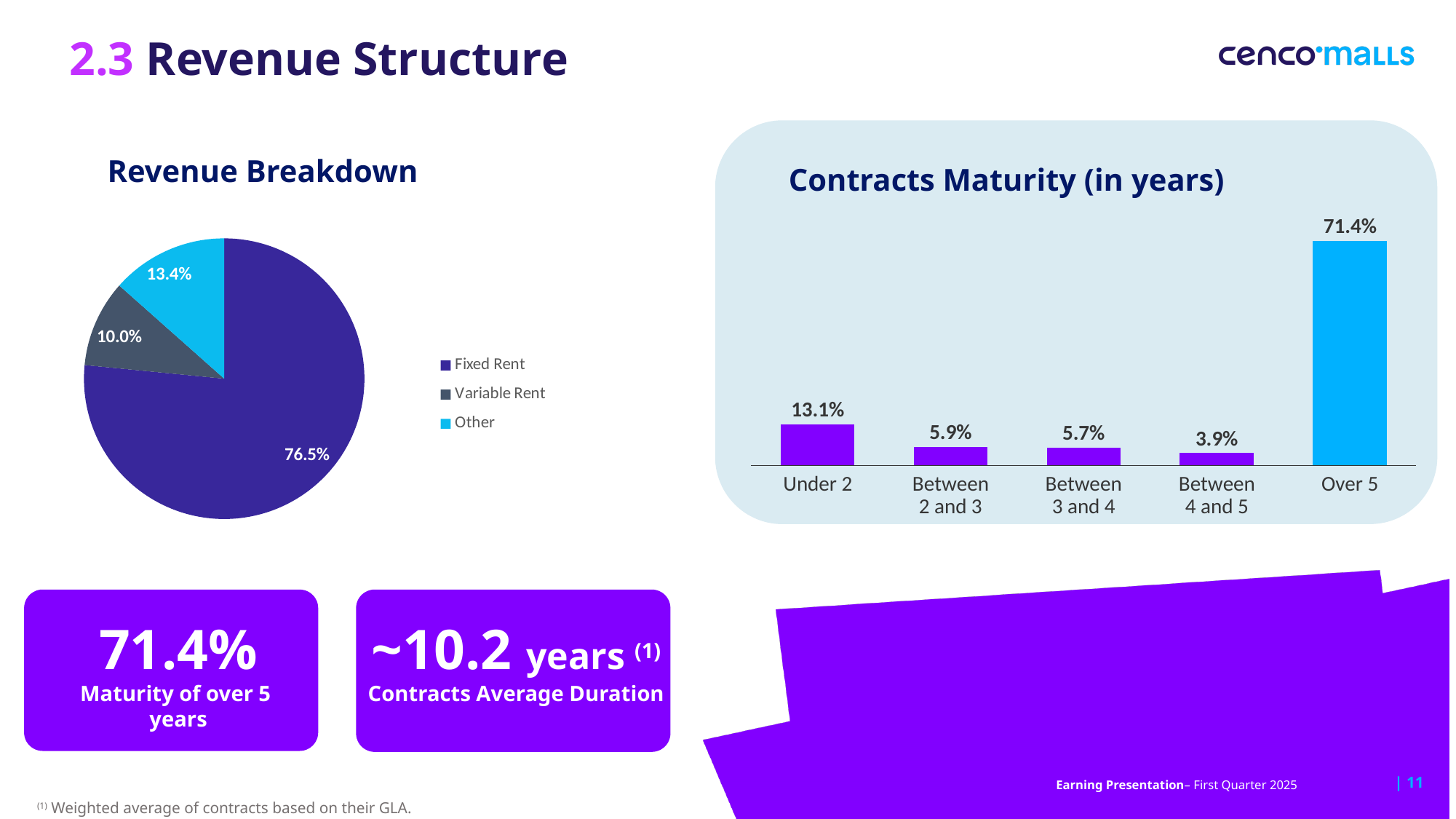
In the Revenue Breakdown pie chart, how many categories does the legend list? 3 In the Contracts Maturity (in years) chart, what is the difference between Under 2 and Between 2 and 3? 7.2% How many categories are shown in the Contracts Maturity (in years) chart? 5 What kind of chart is the Contracts Maturity (in years) chart? Bar chart In the Contracts Maturity (in years) chart, which category has the lowest value? Between 4 and 5 In the Contracts Maturity (in years) chart, what is the value for Over 5? 71.4% In the Contracts Maturity (in years) chart, what is the value for Between 3 and 4? 5.7% What kind of chart is the Revenue Breakdown chart? Pie chart In the Revenue Breakdown pie chart, what share does Variable Rent have? 10.0% In the Contracts Maturity (in years) chart, which is larger: Under 2 or Between 4 and 5? Under 2 In the Revenue Breakdown pie chart, what share does Fixed Rent have? 76.5% In the Revenue Breakdown pie chart, which category has the smallest slice? Variable Rent